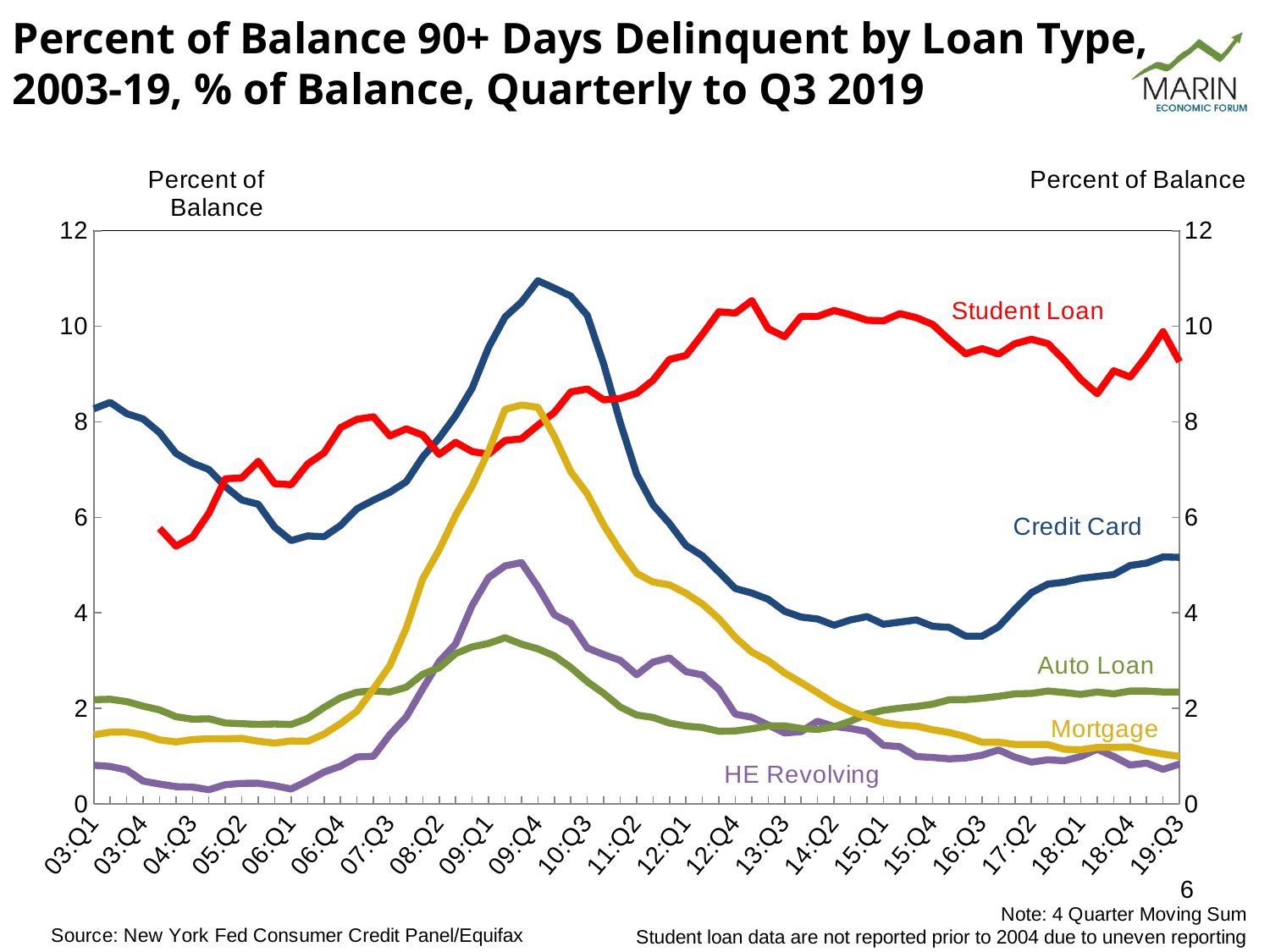
What colour is the Student Loan line? Red How many loan types are plotted as lines on the chart? 5 Which loan type reached the highest peak value over the whole period? Credit Card What kind of chart is shown on the slide? Line chart Does the Credit Card line rise or fall between 09:Q4 and 16:Q3? Fall Does the Mortgage line rise or fall between 09:Q4 and 19:Q3? Fall Is the peak value of the Credit Card line greater or less than 10? greater Is the HE Revolving value at 19:Q3 greater or less than 2? less Which loan type has the highest delinquency rate at 19:Q3? Student Loan Is the peak value of the Mortgage line greater or less than 8? greater At 19:Q3, which is larger: the Student Loan value or the Credit Card value? Student Loan